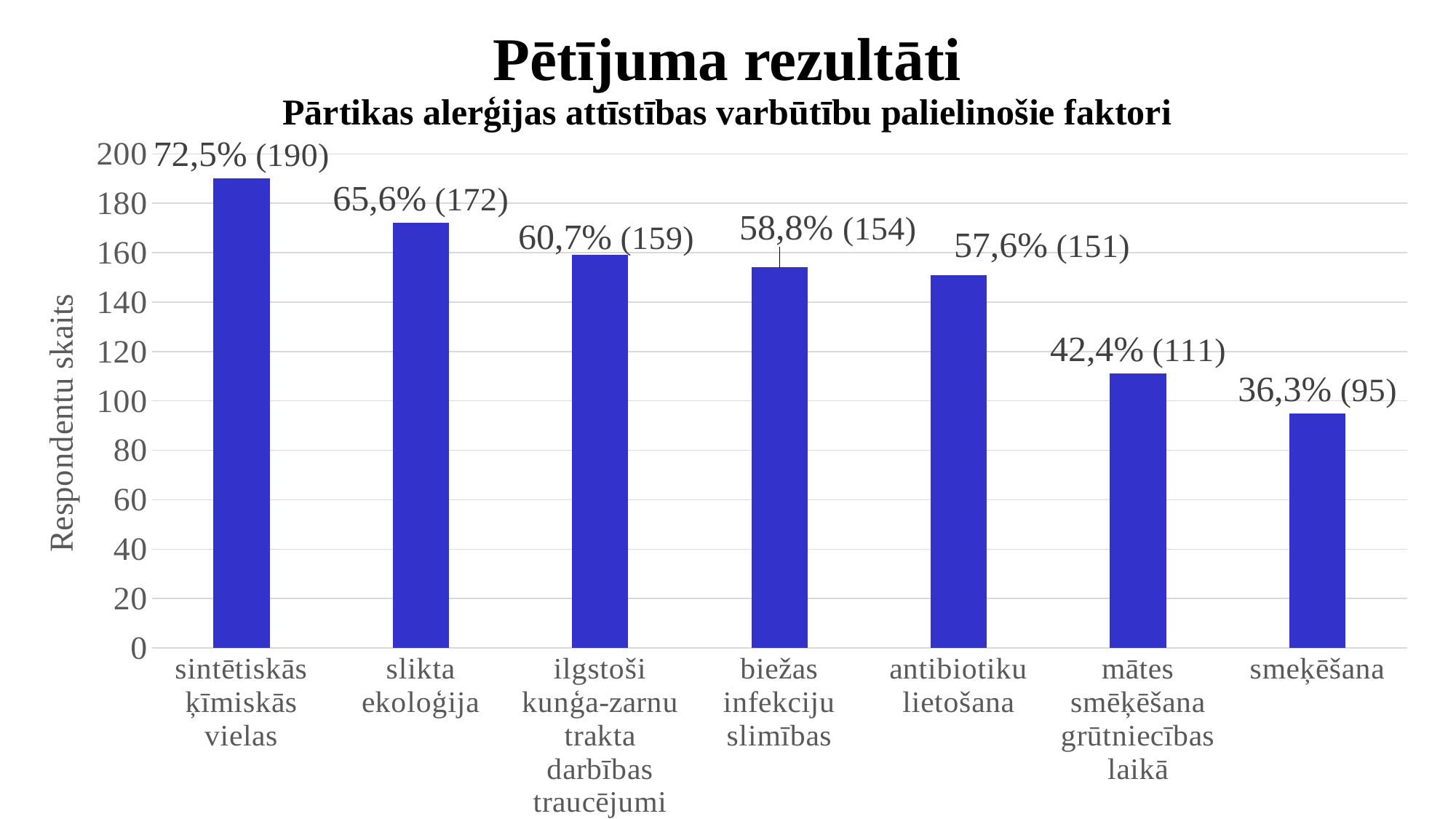
Which category has the lowest number of respondents? smeķēšana What is the difference in respondent count between 'sintētiskās ķīmiskās vielas' and 'smeķēšana'? 95 What kind of chart is shown on the slide? bar chart How many categories are shown in the chart? 7 What is the data label for 'slikta ekoloģija'? 65,6% (172) Which has more respondents: 'biežas infekciju slimības' or 'mātes smēķēšana grūtniecības laikā'? biežas infekciju slimības What is the label of the vertical axis? Respondentu skaits How many respondents are shown for 'antibiotiku lietošana'? 151 Which category has the highest number of respondents? sintētiskās ķīmiskās vielas What is the difference in respondent count between 'slikta ekoloģija' and 'ilgstoši kunģa-zarnu trakta darbības traucējumi'? 13 Is the value for 'mātes smēķēšana grūtniecības laikā' greater or less than 100? greater What percentage is shown for 'smeķēšana'? 36,3%